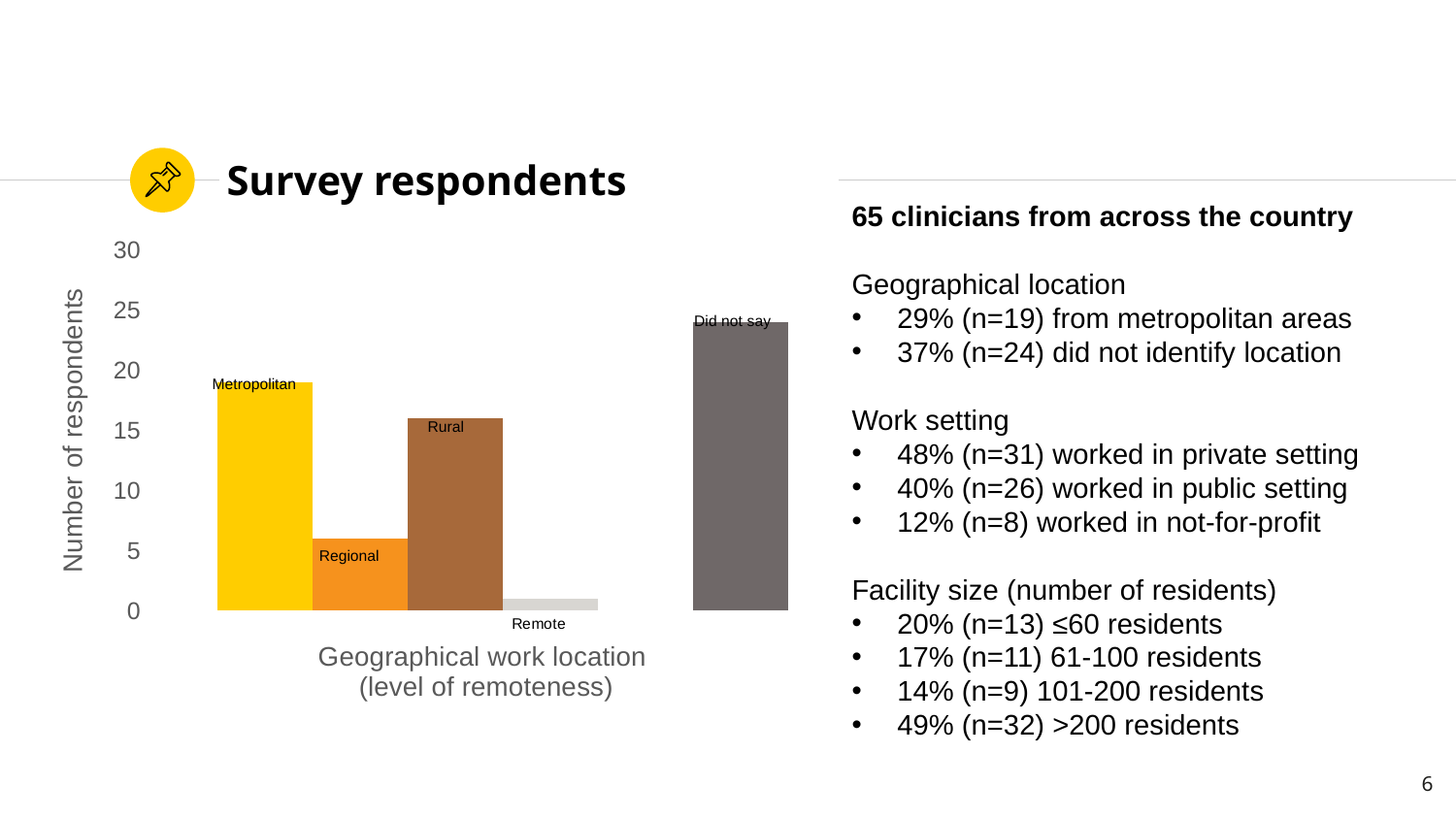
What is the title of the vertical axis of the chart? Number of respondents Is the value for Did not say greater or less than 20? greater Is the value for Remote greater or less than 5? less Which category has the lowest number of respondents? Remote How many categories are plotted in the chart? 5 Which has more respondents, Metropolitan or Rural? Metropolitan Which category has the highest number of respondents? Did not say Is the value for Metropolitan greater or less than 15? greater Which has more respondents, Rural or Regional? Rural Which has more respondents, Metropolitan or Regional? Metropolitan What kind of chart is shown on the slide? bar chart